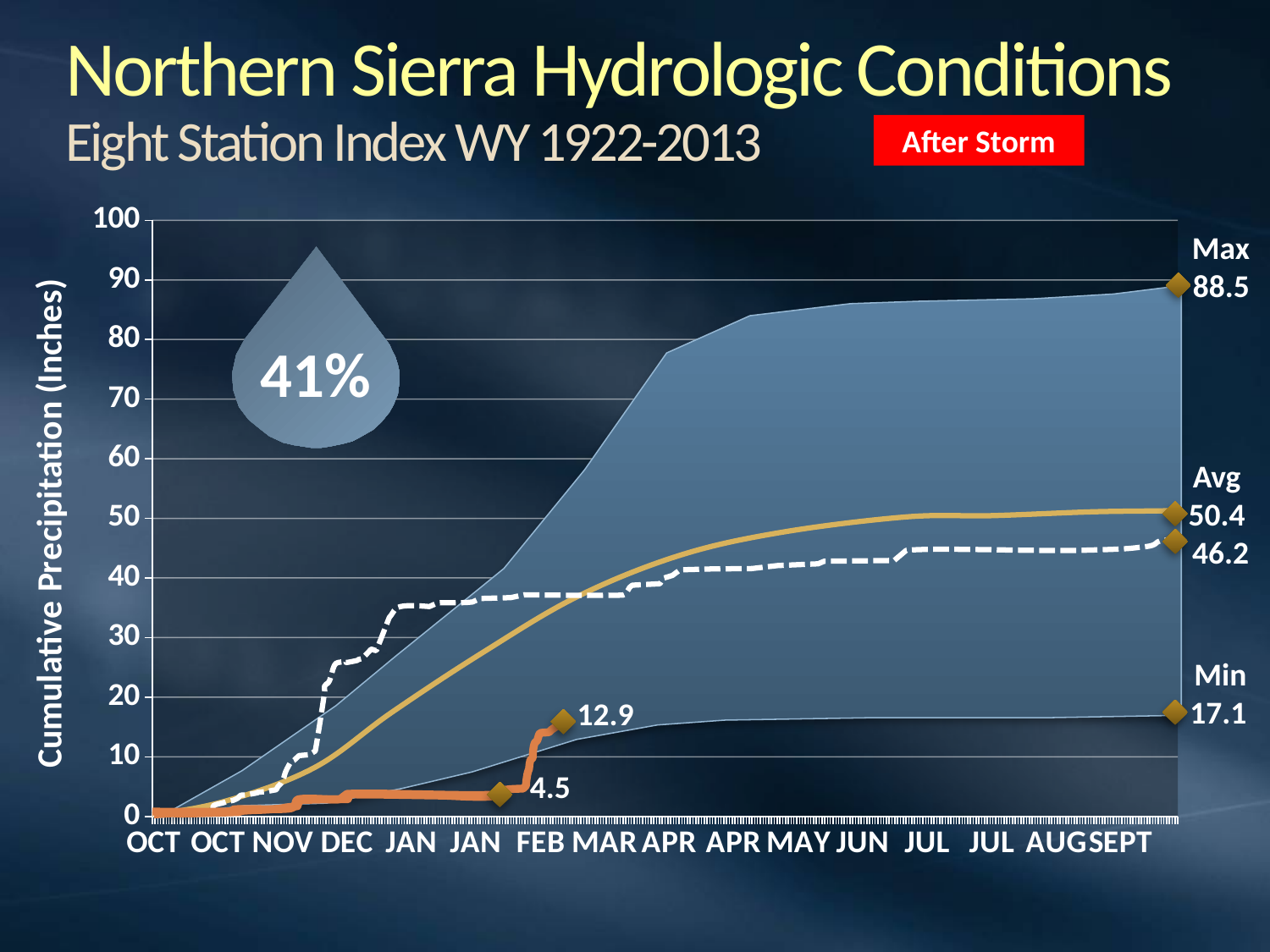
Which is larger at the end of the chart: the Avg value or the value labeled 46.2 on the dashed white line? Avg What value is labeled on the orange line just before it jumps to 12.9? 4.5 By how much did the orange line increase between its 4.5 label and its 12.9 label? 8.4 Does the Avg line rise or fall from OCT to SEPT? rise What percentage is shown inside the water droplet on the chart? 41% What is the latest value labeled on the orange line? 12.9 What is the difference between the Max value (88.5) and the Min value (17.1)? 71.4 What is the Avg value labeled at the end of the chart? 50.4 Is the value of the dashed white line at JAN greater or less than 40? less What is the Max value labeled at the end of the chart? 88.5 What is the Min value labeled at the end of the chart? 17.1 What is the label on the y-axis of the chart? Cumulative Precipitation (Inches)